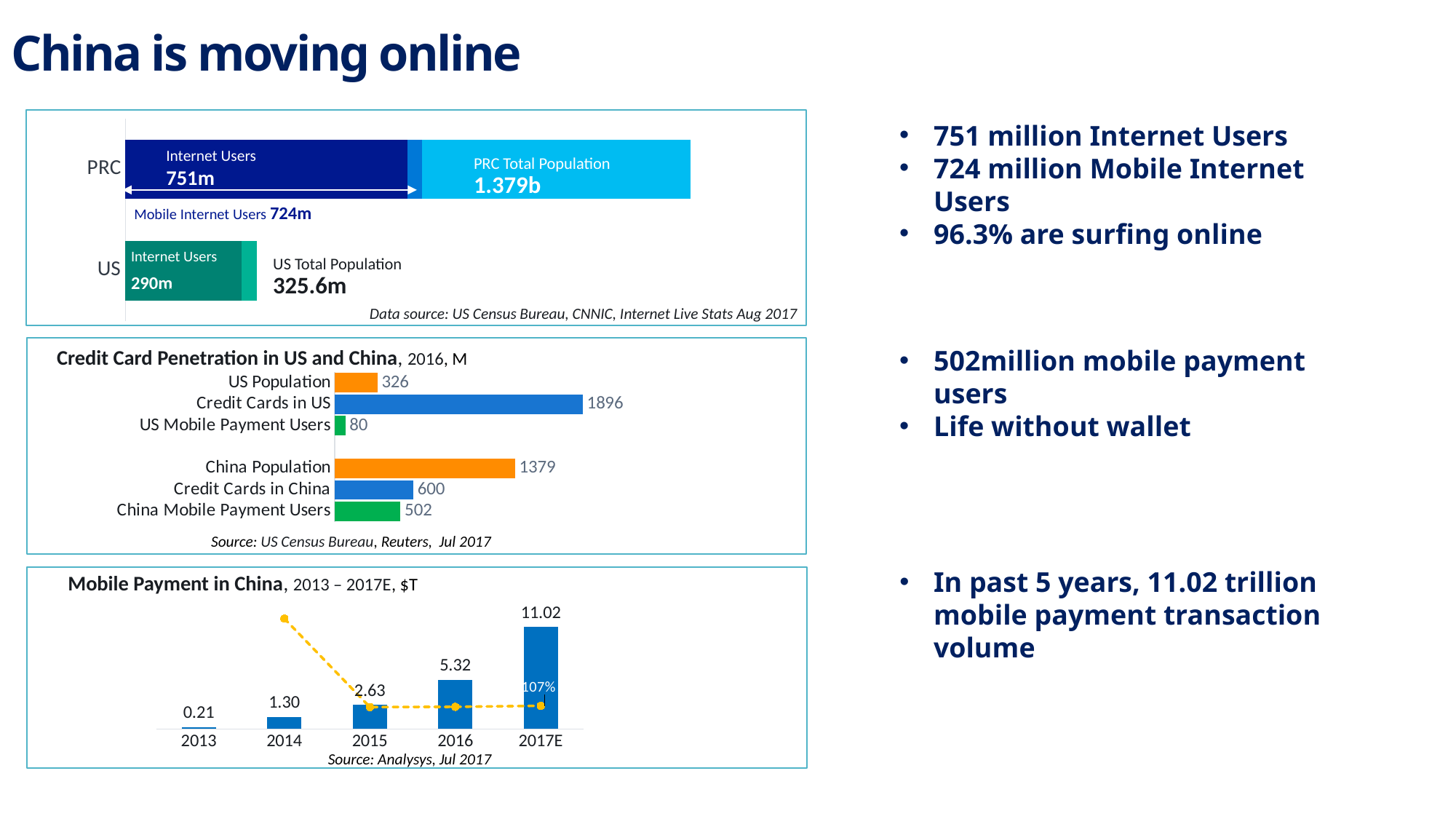
In the 'Credit Card Penetration in US and China' chart, which category has the lowest value? US Mobile Payment Users In the 'Credit Card Penetration in US and China' chart, what is the difference between China Population and Credit Cards in China? 779 In the 'Credit Card Penetration in US and China' chart, how many categories are plotted? 6 In the 'Credit Card Penetration in US and China' chart, which is larger: Credit Cards in China or China Mobile Payment Users? Credit Cards in China In the 'Mobile Payment in China' chart, which year has the highest value? 2017E In the 'Mobile Payment in China' chart, what is the value for 2016? 5.32 In the 'Mobile Payment in China' chart, do the bar values rise or fall from 2013 to 2017E? rise In the 'Credit Card Penetration in US and China' chart, which category has the highest value? Credit Cards in US In the 'Mobile Payment in China' chart, what is the difference between the 2017E and 2016 values? 5.70 In the 'Credit Card Penetration in US and China' chart, what is the value for Credit Cards in US? 1896 In the 'Credit Card Penetration in US and China' chart, what is the value for China Mobile Payment Users? 502 In the top chart, what is the number of Internet Users shown for the US? 290m